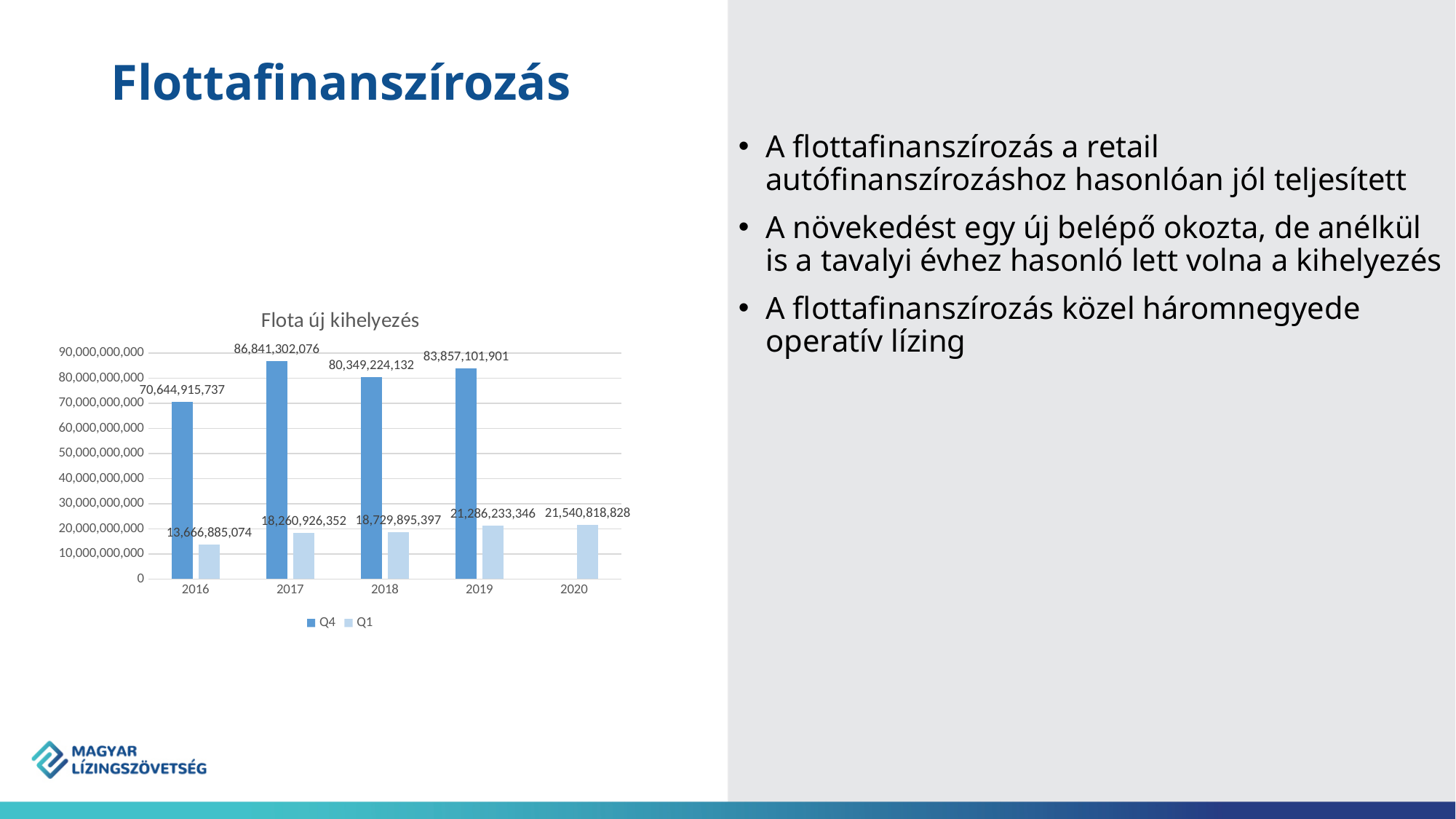
How many series does the chart legend list? 2 What is the difference between the Q4 and Q1 values for 2019? 62,570,868,555 What type of chart is shown on the slide? Bar chart What is the difference between the Q4 values for 2017 and 2016? 16,196,386,339 Which is larger, the Q4 value for 2018 or the Q4 value for 2019? 2019 Which year has the lowest Q1 value? 2016 What is the title of the chart? Flota új kihelyezés Which year has the highest Q4 value? 2017 What is the Q4 value for 2017? 86,841,302,076 What is the Q1 value for 2016? 13,666,885,074 What is the Q1 value for 2020? 21,540,818,828 How many years are shown on the x axis? 5